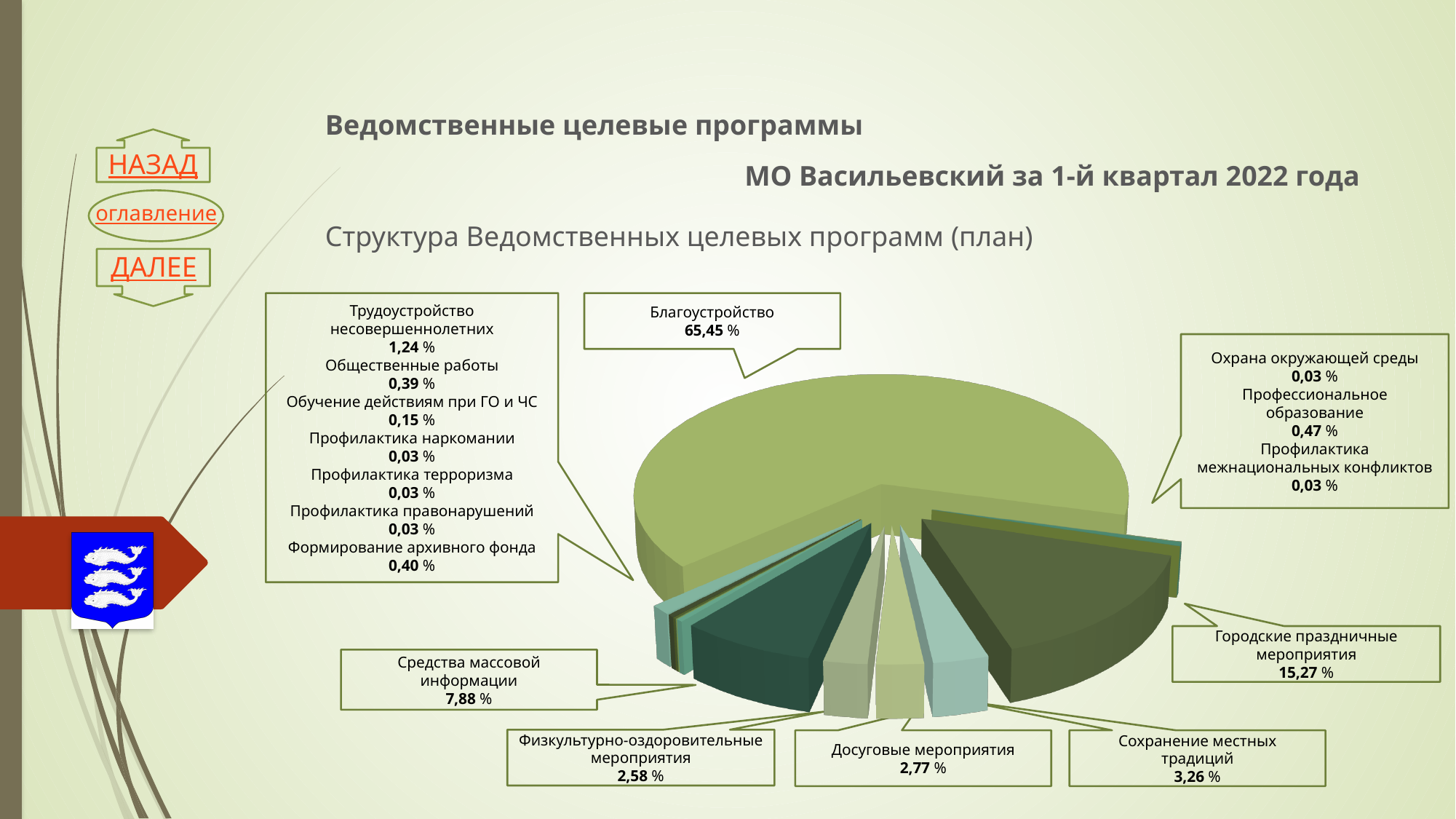
What is the share for Трудоустройство несовершеннолетних? 1,24 % Which category has the largest share of the pie? Благоустройство Which has the larger share: Досуговые мероприятия or Физкультурно-оздоровительные мероприятия? Досуговые мероприятия What is the share for Сохранение местных традиций? 3,26 % What is the share for Профессиональное образование? 0,47 % What is the smallest share value shown on the chart? 0,03 % What is the share for Городские праздничные мероприятия? 15,27 % What is the difference between the shares of Благоустройство and Городские праздничные мероприятия? 50,18 % What kind of chart is shown on the slide? pie chart What is the share for Средства массовой информации? 7,88 % What is the subtitle of the chart shown on the slide? Структура Ведомственных целевых программ (план) What is the share for Благоустройство? 65,45 %